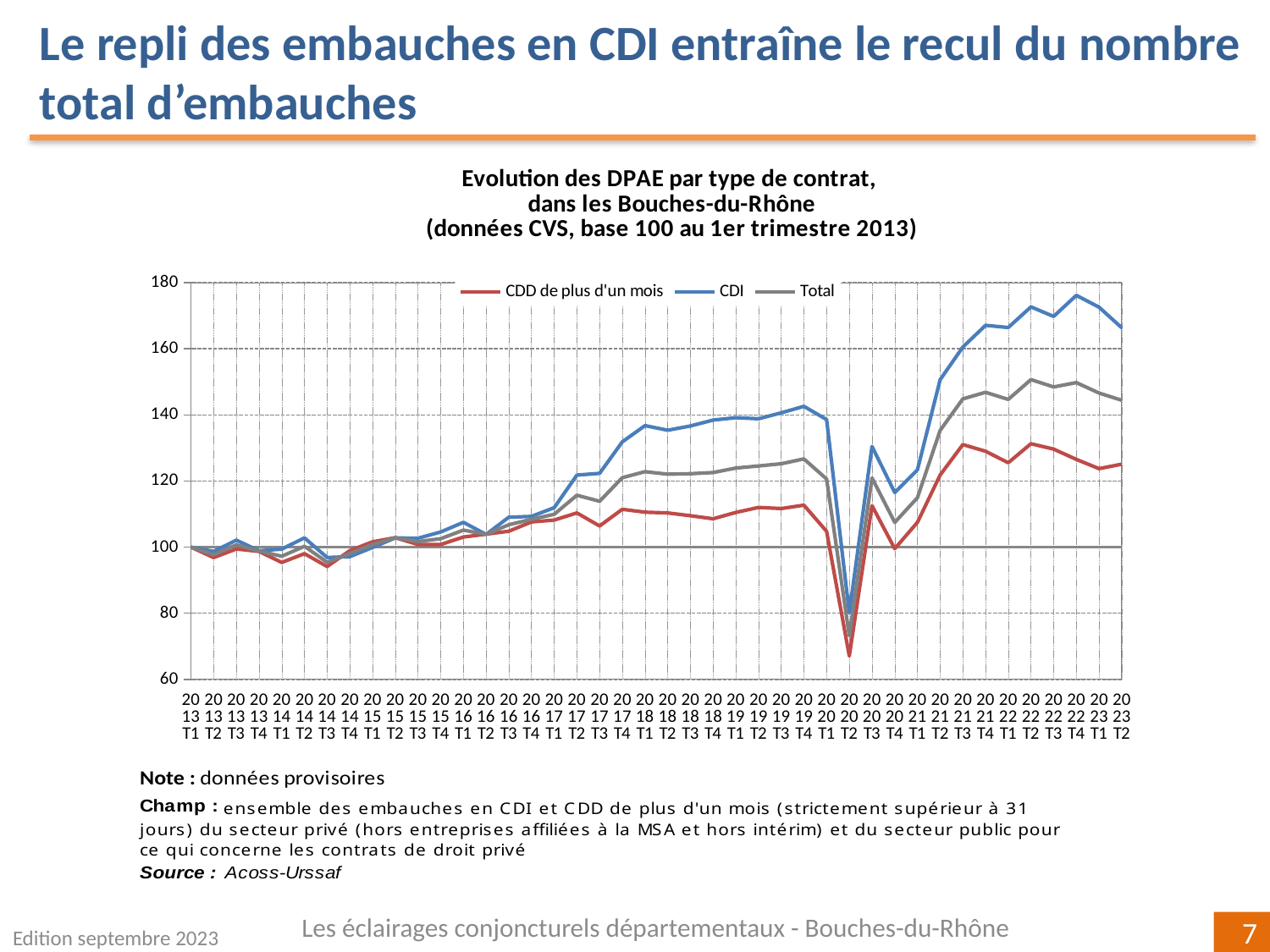
What is the value of the CDI series at 2013 T1, the base quarter? 100 Is the value of the CDI series at 2022 T4 greater or less than 160? greater Is the value of the Total series at 2023 T2 greater or less than 140? greater Which series is drawn in blue? CDI How many quarterly points are plotted along the x axis, from 2013 T1 to 2023 T2? 42 Does the CDI series rise or fall between 2023 T1 and 2023 T2? fall At 2023 T2, which series is higher: CDI or CDD de plus d'un mois? CDI What is the base period stated in the chart title? base 100 au 1er trimestre 2013 Which series has the lowest value at 2020 T2? CDD de plus d'un mois Is the value of the CDD de plus d'un mois series at 2020 T2 greater or less than 80? less How many series does the legend list? 3 What kind of chart is shown on the slide? line chart